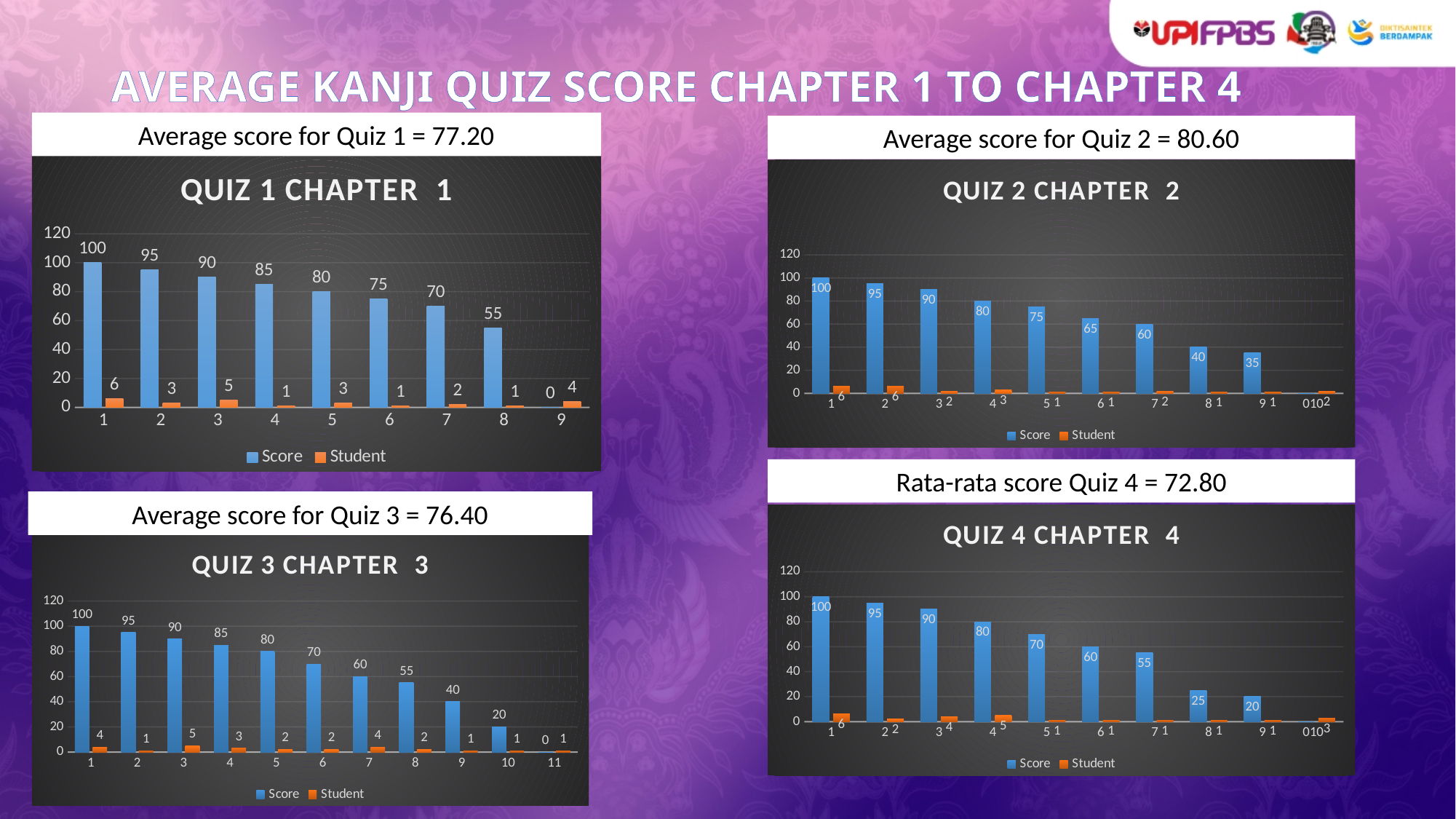
In the Quiz 2 Chapter 2 chart, what is the difference between the Score values for category 1 and category 8? 60 In the Quiz 3 Chapter 3 chart, do the Score values rise or fall from category 1 to category 11? fall In the Quiz 1 Chapter 1 chart, how many categories are shown on the x axis? 9 In the Quiz 2 Chapter 2 chart, what is the Score value for category 9? 35 In the Quiz 1 Chapter 1 chart, what is the Score value for category 8? 55 In the Quiz 3 Chapter 3 chart, how many categories are shown on the x axis? 11 In the Quiz 4 Chapter 4 chart, what is the Score value for category 8? 25 In the Quiz 3 Chapter 3 chart, which category has the highest Student value? 3 How many series does the legend of the Quiz 4 Chapter 4 chart list? 2 In the Quiz 1 Chapter 1 chart, what is the Student value for category 1? 6 What type of chart is the Quiz 2 Chapter 2 chart? bar chart In the Quiz 4 Chapter 4 chart, which is larger, the Student value for category 1 or for category 4? category 1